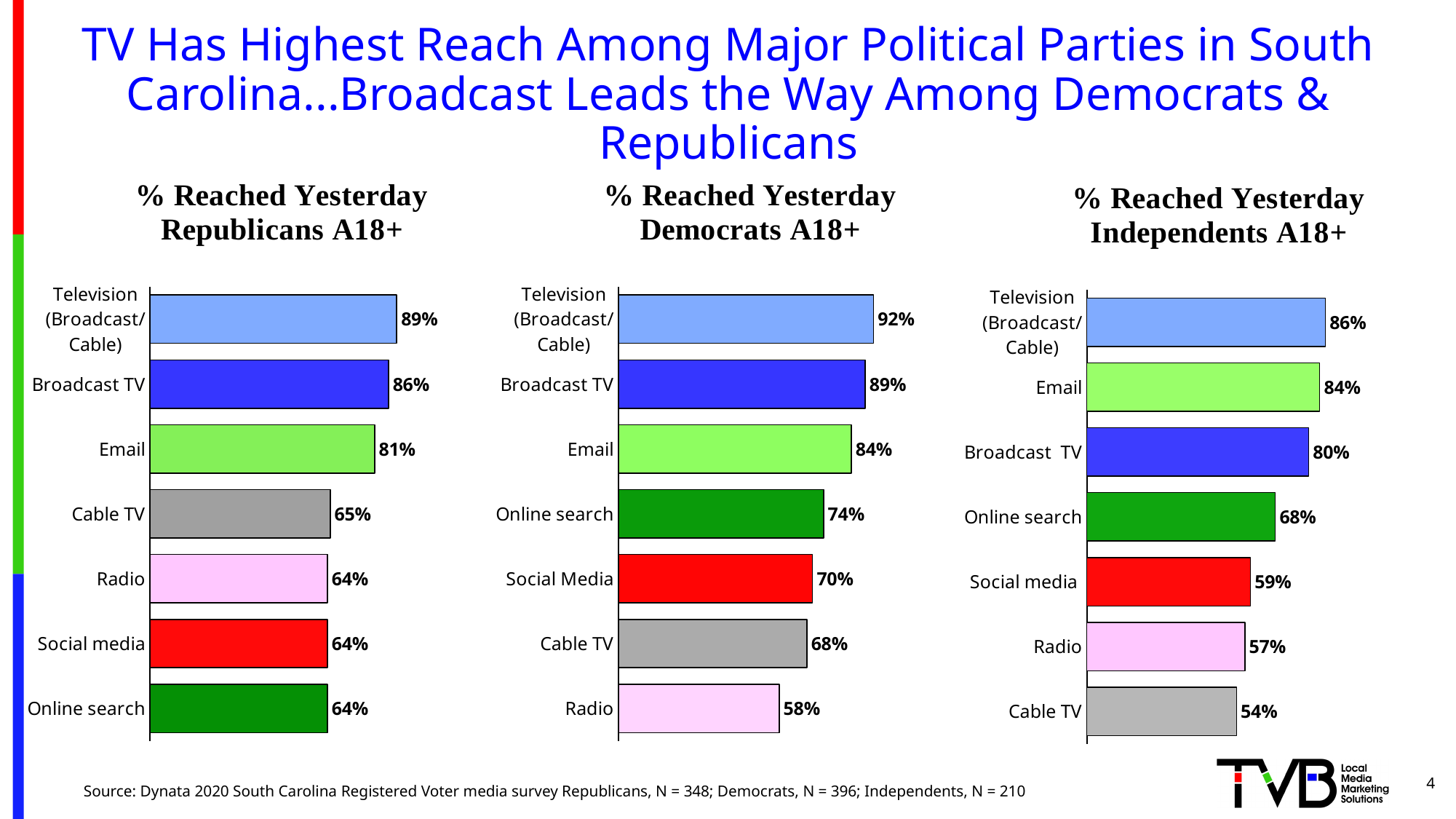
In the '% Reached Yesterday Independents A18+' chart, what is the value for Cable TV? 54% In the '% Reached Yesterday Independents A18+' chart, which category has the lowest value? Cable TV In the '% Reached Yesterday Democrats A18+' chart, which is larger, Social Media or Cable TV? Social Media In the '% Reached Yesterday Republicans A18+' chart, what is the value for Email? 81% In the '% Reached Yesterday Independents A18+' chart, what is the difference between Email and Broadcast TV? 4% How many charts are shown on the slide? 3 In the '% Reached Yesterday Republicans A18+' chart, what is the difference between Television (Broadcast/Cable) and Cable TV? 24% In the '% Reached Yesterday Democrats A18+' chart, which category has the highest value? Television (Broadcast/Cable) What type of chart is the '% Reached Yesterday Democrats A18+' chart? Bar chart In the '% Reached Yesterday Republicans A18+' chart, what is the value for Broadcast TV? 86% In the '% Reached Yesterday Democrats A18+' chart, what is the value for Online search? 74% How many categories are shown in the '% Reached Yesterday Republicans A18+' chart? 7